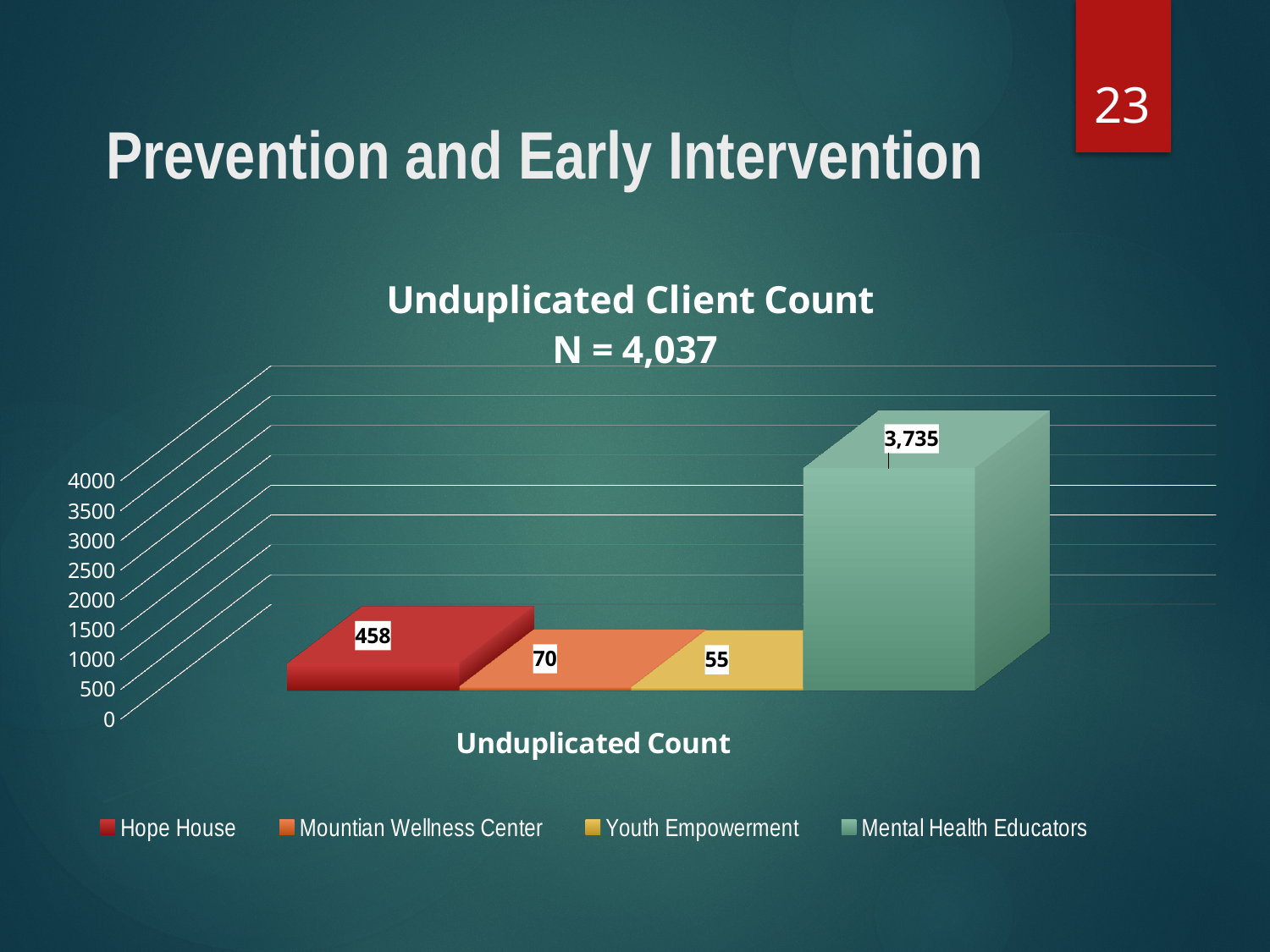
What is the difference between the Mountian Wellness Center count and the Youth Empowerment count? 15 Which series has the lowest unduplicated client count? Youth Empowerment Which series has the highest unduplicated client count? Mental Health Educators What is the unduplicated client count for Mental Health Educators? 3,735 What kind of chart is shown on the slide? Bar chart What is the unduplicated client count for Youth Empowerment? 55 What is the title of the chart? Unduplicated Client Count N = 4,037 What is the difference between the Mental Health Educators count and the Hope House count? 3,277 What is the unduplicated client count for Hope House? 458 How many series does the legend list? 4 What is the unduplicated client count for Mountian Wellness Center? 70 Which is larger, the count for Hope House or the count for Mountian Wellness Center? Hope House